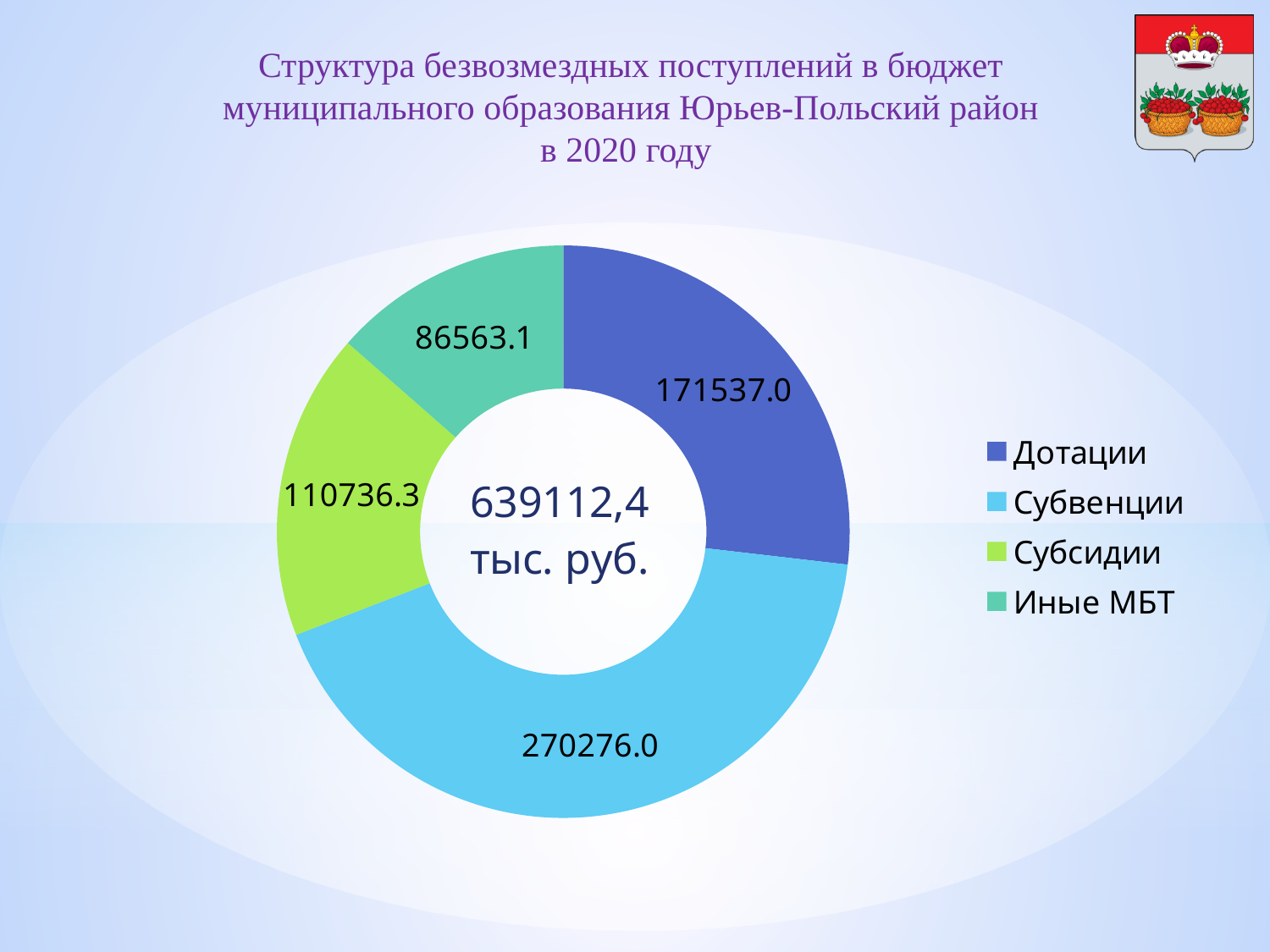
What is the value for Субсидии? 110736.3 What kind of chart is shown on the slide? Doughnut (pie) chart What is the difference between the values for Субвенции and Дотации? 98739.0 Which category has the smallest value? Иные МБТ What is the value for Иные МБТ? 86563.1 What total is printed in the centre of the chart? 639112,4 тыс. руб. What is the difference between the values for Субсидии and Иные МБТ? 24173.2 Which category has the largest value? Субвенции What is the value for Субвенции? 270276.0 Which is larger, Дотации or Субсидии? Дотации How many categories does the chart show? 4 What is the value for Дотации? 171537.0